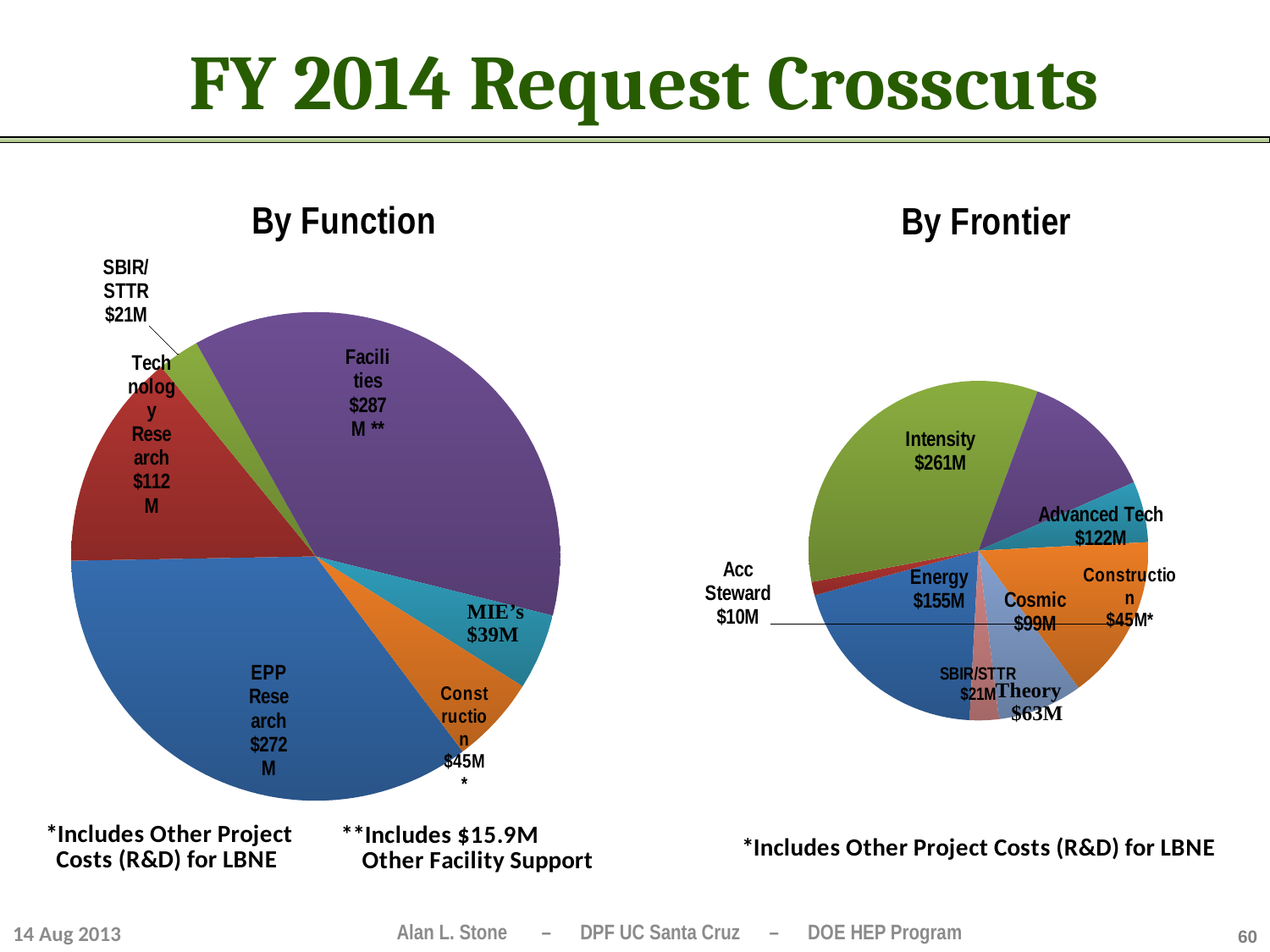
How many slices does the By Function pie chart have? 6 What type of chart is the By Frontier chart? Pie chart In the By Frontier pie chart, what is the difference between Intensity and Energy? $106M In the By Frontier pie chart, what is the value for Theory? $63M In the By Frontier pie chart, what is the value for Intensity? $261M In the By Function pie chart, which category has the smallest slice? SBIR/STTR In the By Frontier pie chart, which is larger, Energy or Advanced Tech? Energy How many slices does the By Frontier pie chart have? 8 In the By Function pie chart, how much larger is Facilities than EPP Research? $15M In the By Function pie chart, what is the value for Facilities? $287M In the By Frontier pie chart, which category has the smallest value? Acc Steward In the By Function pie chart, which category has the largest slice? Facilities